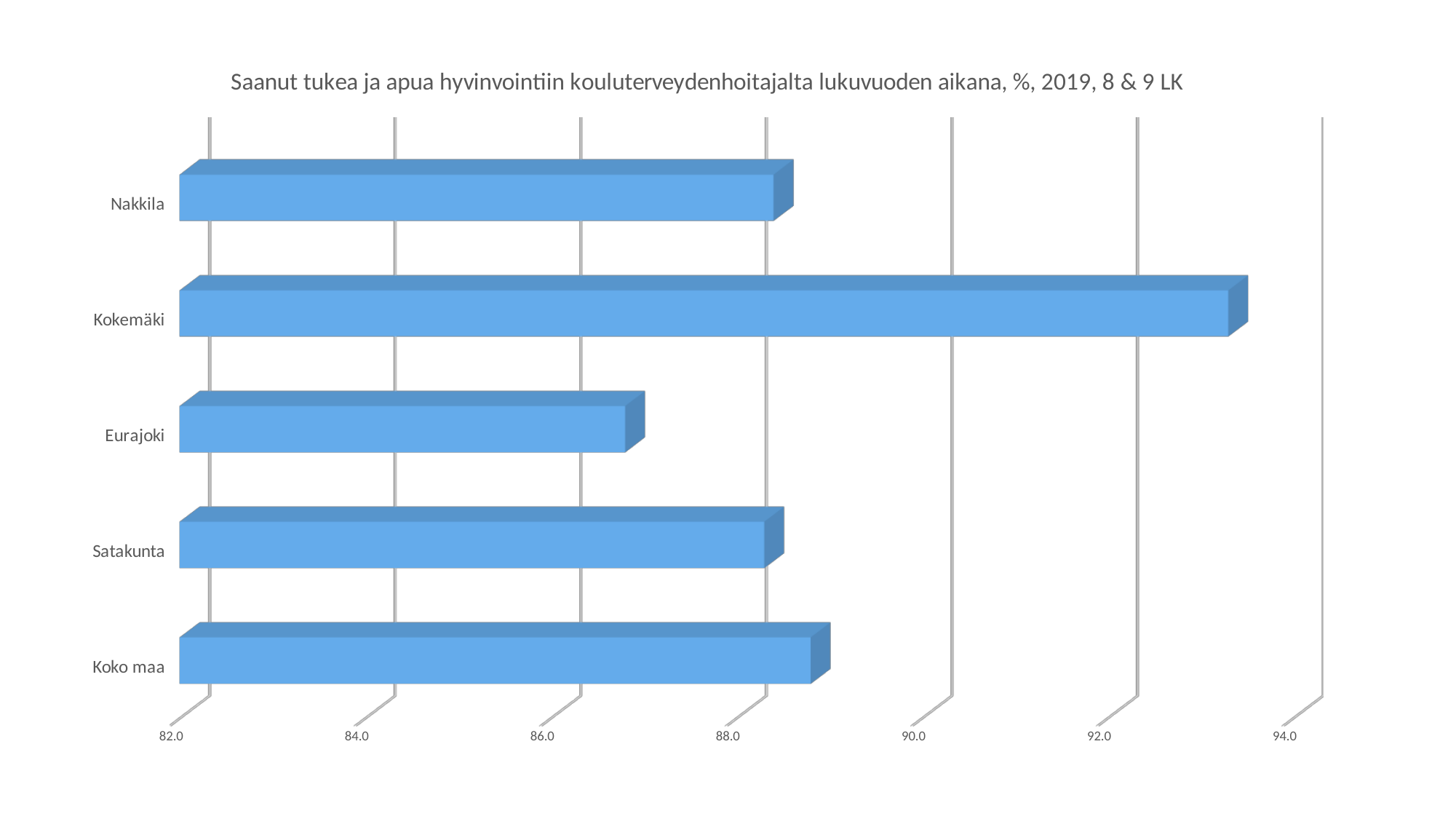
Which has a larger value, Kokemäki or Eurajoki? Kokemäki Is the value for Koko maa greater or less than 88.0? greater Is the value for Kokemäki greater or less than 92.0? greater Is the value for Eurajoki greater or less than 88.0? less What kind of chart is shown on the slide? bar chart Which has a larger value, Koko maa or Eurajoki? Koko maa Which category has the highest value in the chart? Kokemäki Which category has the lowest value in the chart? Eurajoki What is the title of the chart? Saanut tukea ja apua hyvinvointiin kouluterveydenhoitajalta lukuvuoden aikana, %, 2019, 8 & 9 LK How many categories are plotted in the chart? 5